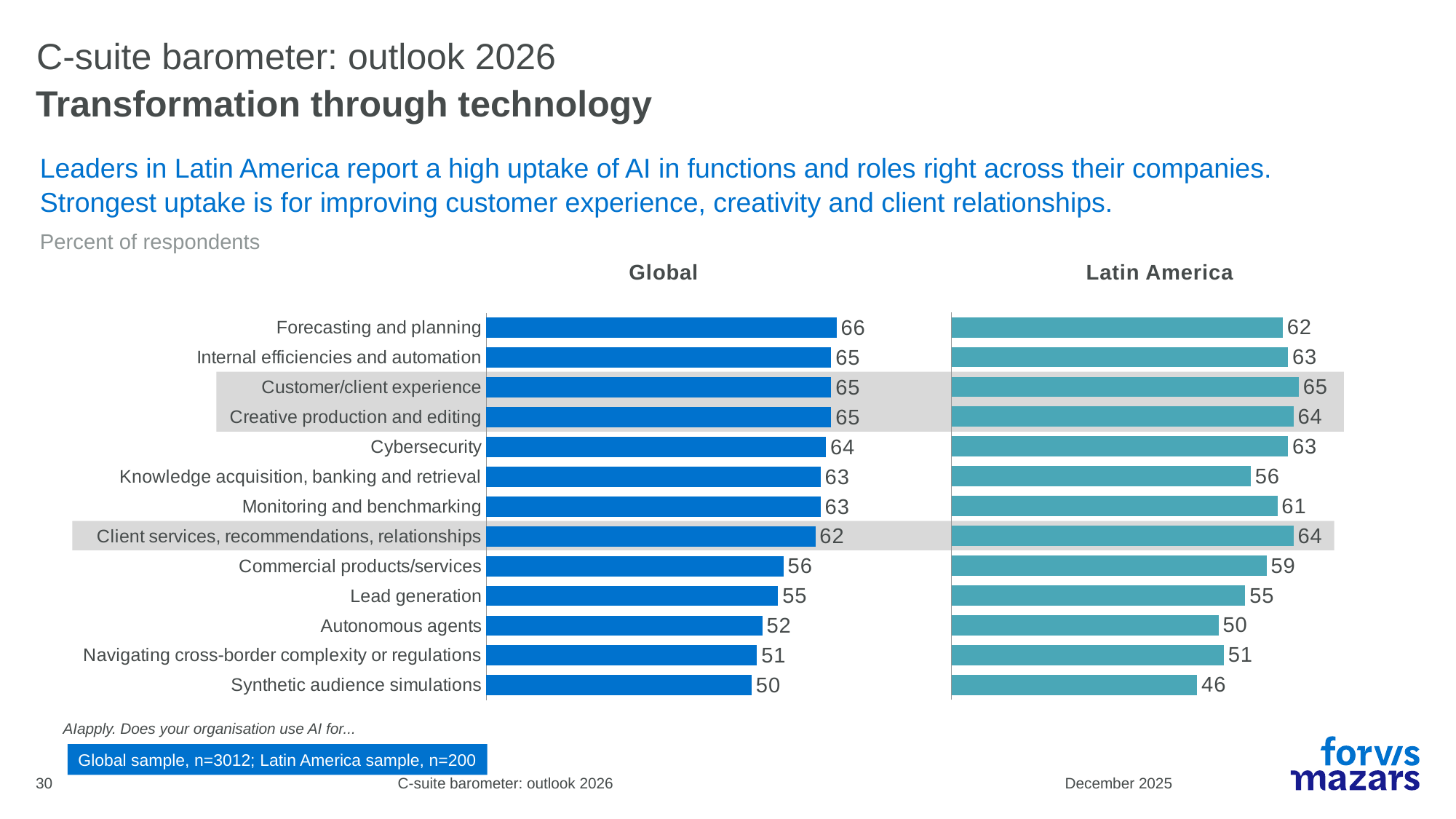
What kind of chart is used on this slide? Bar chart For Client services, recommendations, relationships, which is larger: the Global value or the Latin America value? Latin America In the Global chart, which category has the highest value? Forecasting and planning In the Latin America chart, which category has the lowest value? Synthetic audience simulations What is the difference between the Global and Latin America values for Knowledge acquisition, banking and retrieval? 7 What is the sample size for Latin America stated on the slide? n=200 How many categories are shown in the Global chart? 13 In the Global chart, which category has the lowest value? Synthetic audience simulations In the Latin America chart, what is the difference between Forecasting and planning and Synthetic audience simulations? 16 In the Global chart, what is the value for Forecasting and planning? 66 In the Latin America chart, what is the value for Customer/client experience? 65 In the Latin America chart, what is the value for Knowledge acquisition, banking and retrieval? 56